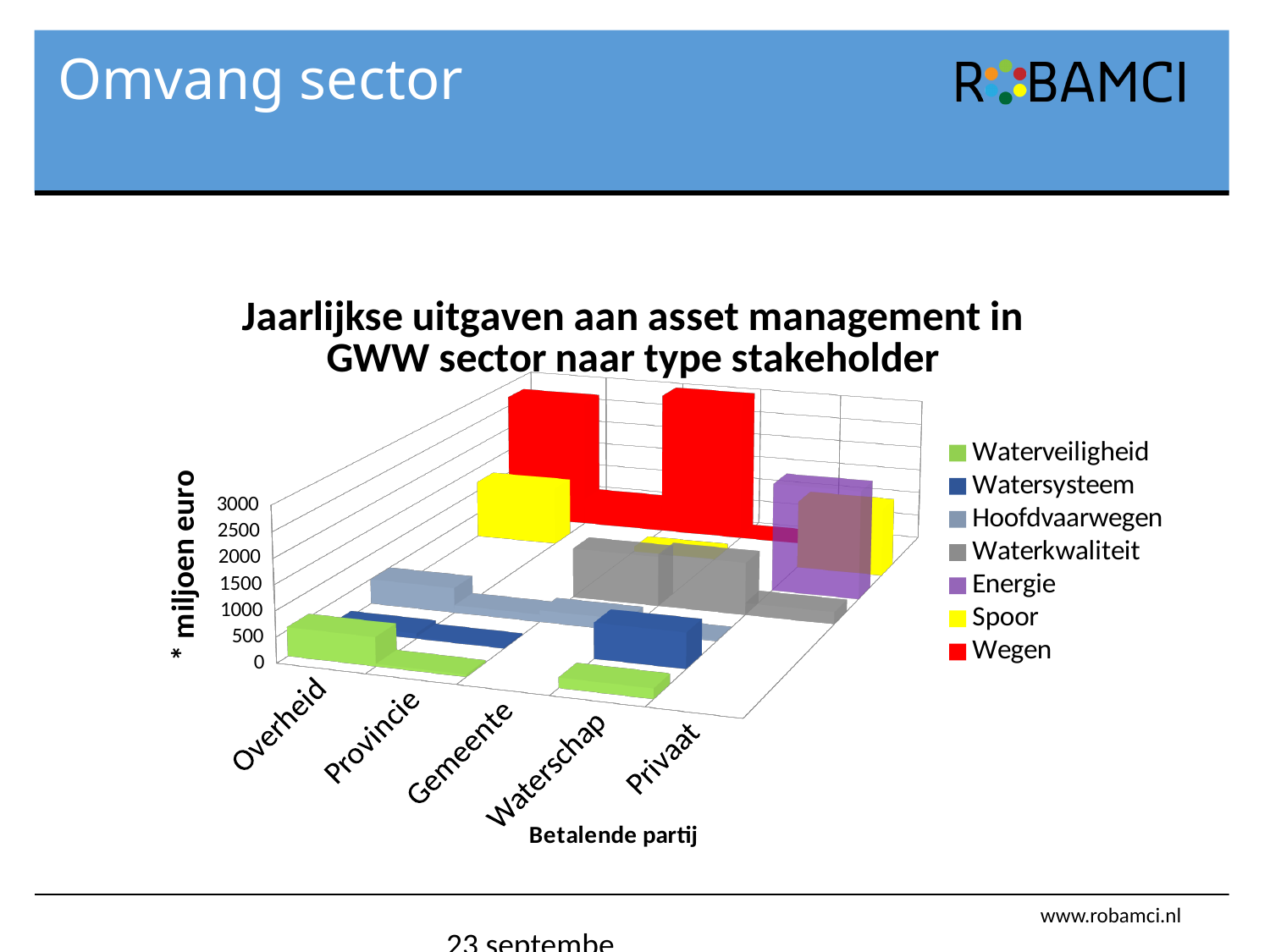
What kind of chart is shown on the slide? bar chart Is the value for Watersysteem at Waterschap greater or less than 2000? less How many categories (betalende partijen) are shown on the x axis of the chart? 5 Which series has the tallest bar in the chart? Wegen How many series does the chart legend list? 7 Is the value for Waterveiligheid at Overheid greater or less than 1500? less What is the title of the chart? Jaarlijkse uitgaven aan asset management in GWW sector naar type stakeholder Which is larger in the chart: the Wegen value for Overheid or the Waterveiligheid value for Overheid? Wegen value for Overheid What is the highest tick value shown on the vertical axis of the chart? 3000 What is the label of the vertical axis of the chart? * miljoen euro Is the value for Wegen at Overheid greater or less than 2000? greater